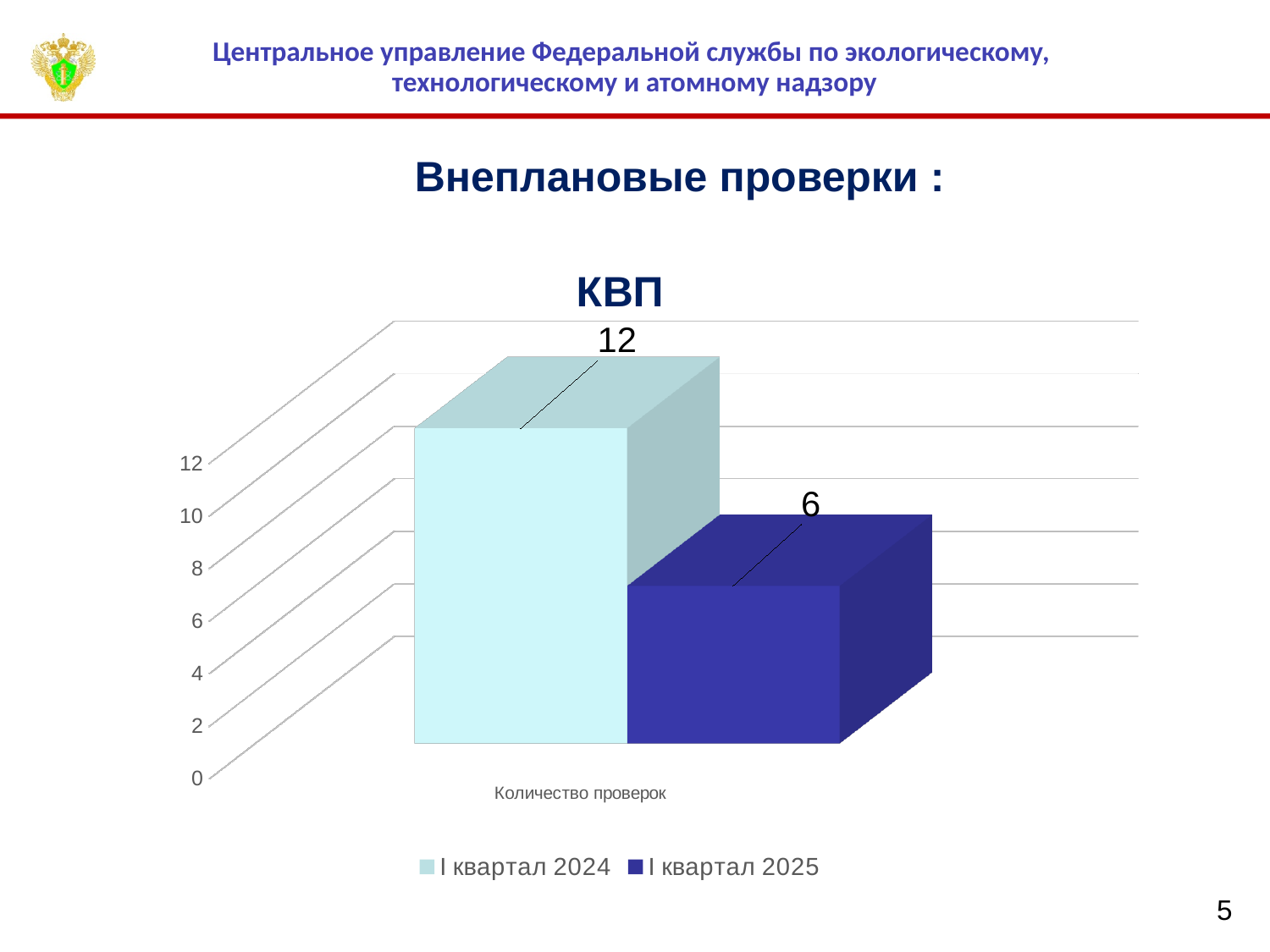
What is the value for I квартал 2024 in the КВП chart? 12 Is the value for I квартал 2024 larger or smaller than the value for I квартал 2025? larger What is the value for I квартал 2025 in the КВП chart? 6 How many series does the legend list in the КВП chart? 2 Which series has the higher value in the КВП chart? I квартал 2024 What is the total of the two values shown in the КВП chart? 18 What is the category label on the x axis of the КВП chart? Количество проверок Is the value for I квартал 2025 greater or less than 10? less What is the title of the chart on the slide? КВП Which series has the lower value in the КВП chart? I квартал 2025 What kind of chart is shown on the slide? bar chart What is the difference between the I квартал 2024 and I квартал 2025 values in the КВП chart? 6